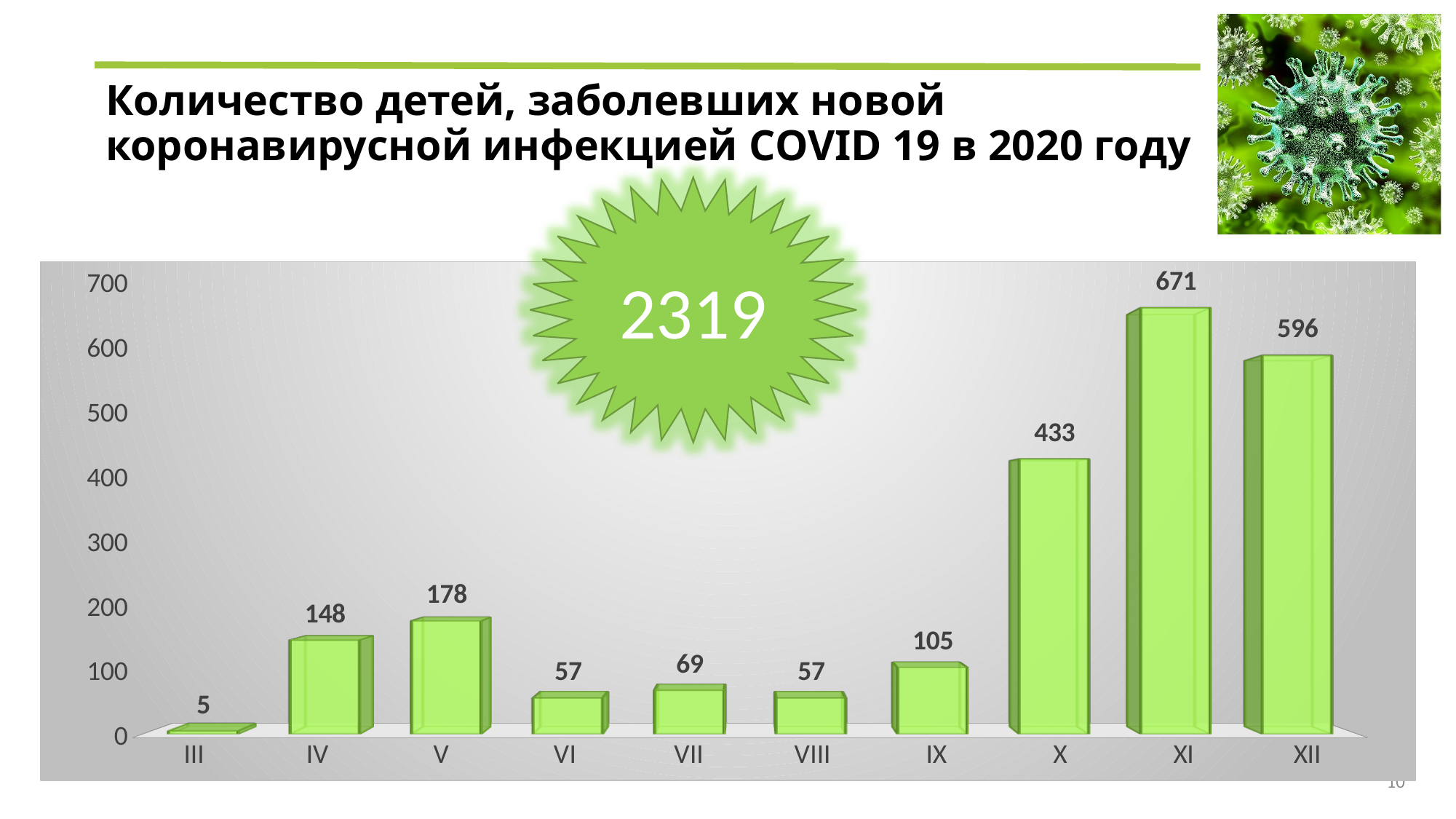
What number is shown in the green starburst above the chart? 2319 Which is larger, the value for VII or the value for VIII? VII What is the difference between the values for XI and XII? 75 Which month has the highest value? XI What is the value for month IX? 105 How many months are shown on the x axis? 10 What is the value for month IV? 148 Which month has the lowest value? III Do the values generally rise or fall from IX to XI? rise What is the value for month XI? 671 What is the difference between the values for X and V? 255 What kind of chart is shown on the slide? bar chart